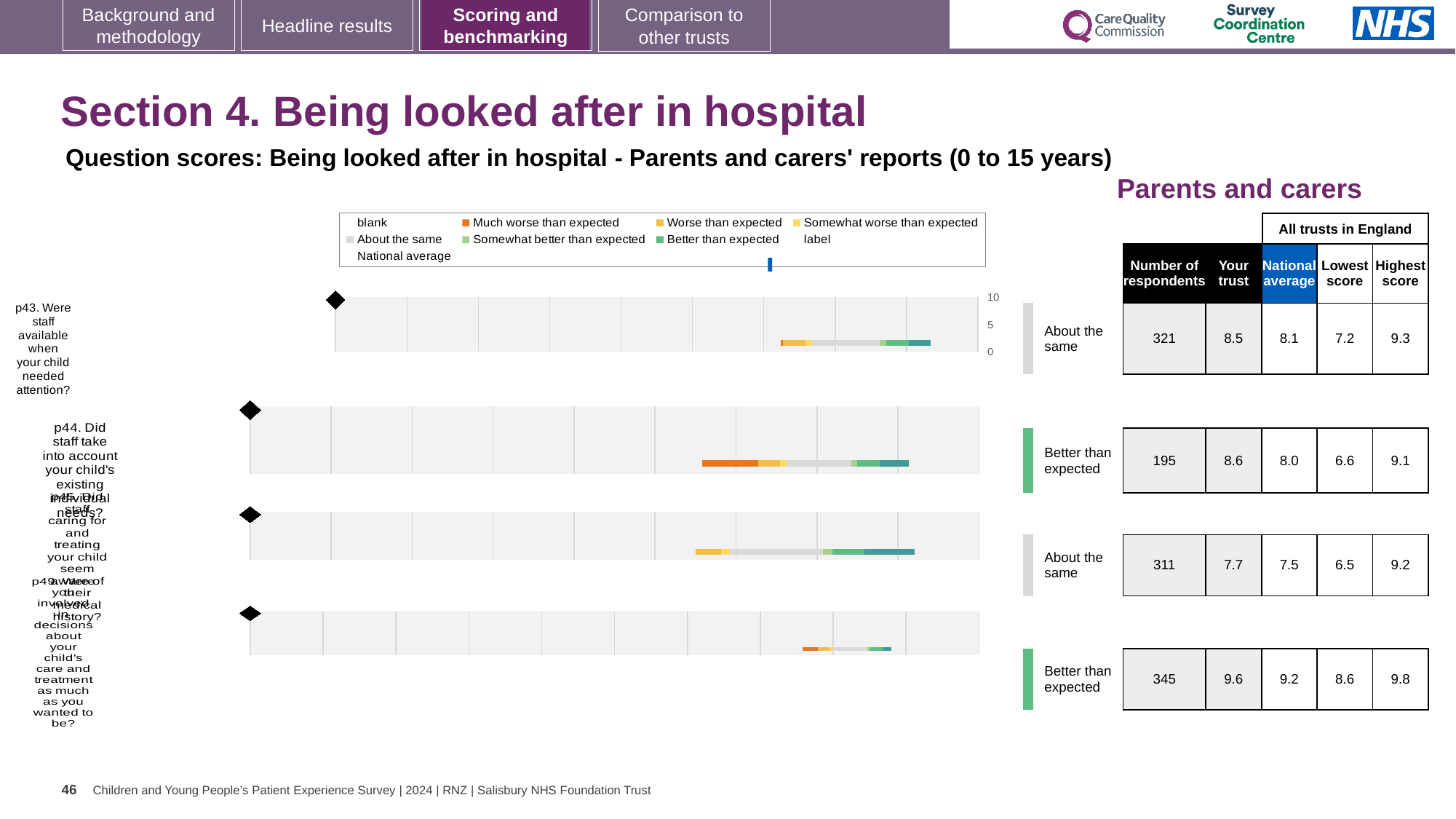
For the top chart (p43), how many respondents are shown in the table? 321 For the top chart (p43), which is larger: the 'Your trust' score or the national average? Your trust (8.5) What kind of chart is used for the p43 question (top chart) on the slide? bar chart For the top chart (p43. Were staff available when your child needed attention?), what is the 'Your trust' score shown in the table? 8.5 Which of the four question charts has the highest 'Your trust' score? The bottom chart (p49), 9.6 Which of the four question charts has the lowest 'Your trust' score? The third chart from the top (p45), 7.7 How many question charts are shown on the slide? 4 For the top chart (p43), what is the national average score? 8.1 What benchmark category is shown for the bottom chart (p49)? Better than expected For the bottom chart (p49), what is the difference between the 'Your trust' score and the national average? 0.4 For the top chart (p43), what is the difference between the highest score and the lowest score across all trusts in England? 2.1 For the second chart from the top (p44), how many respondents are shown in the table? 195